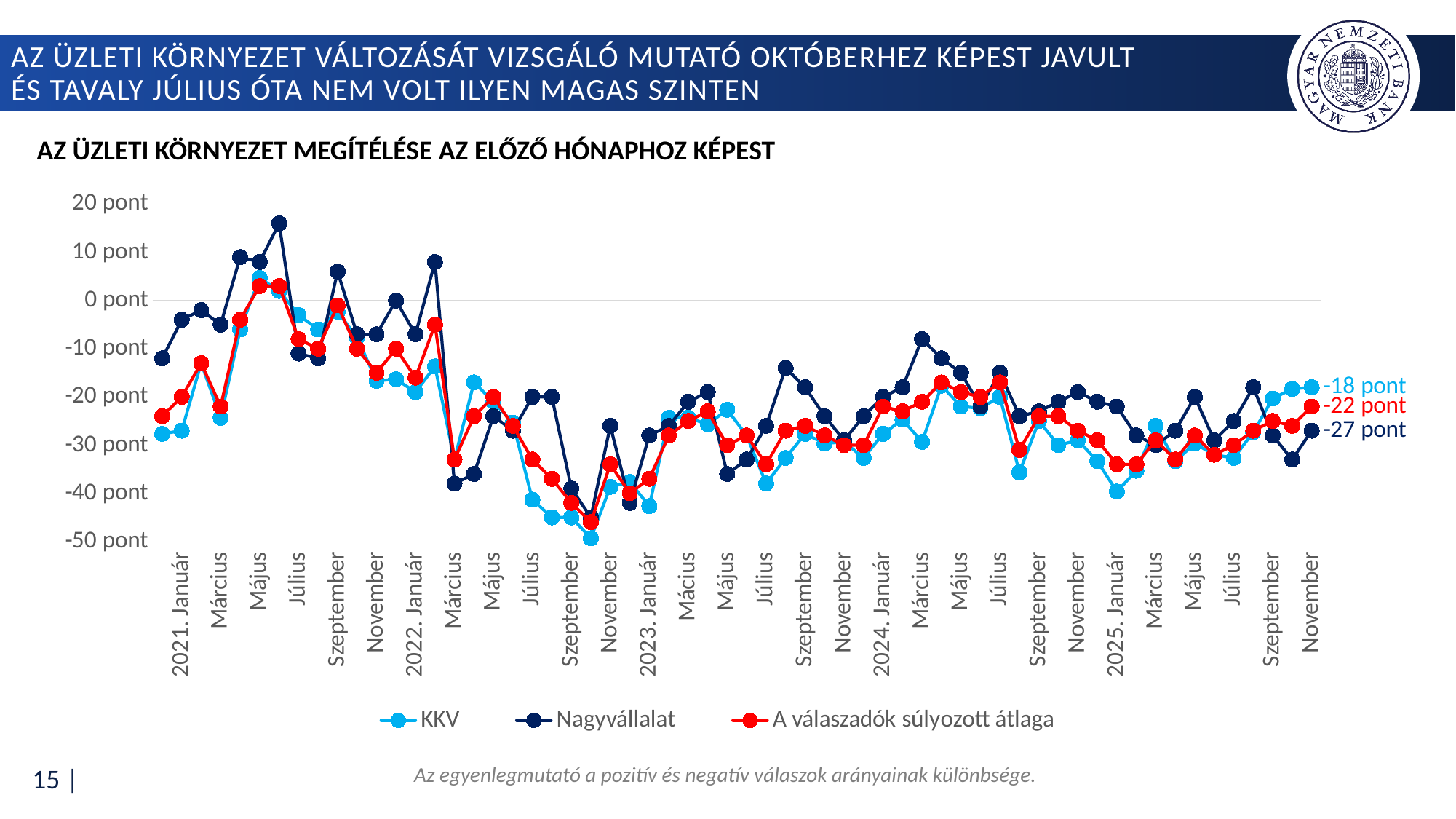
How many series does the legend list? 3 Which series has the highest value at 2025 November? KKV What kind of chart is shown on the slide? line chart What is the value of the Nagyvállalat series at the last point (2025 November)? -27 pont At 2025 November, which is higher: the KKV value or the Nagyvállalat value? KKV What is the value of 'A válaszadók súlyozott átlaga' at the last point (2025 November)? -22 pont What is the value of the KKV series at the last point (2025 November)? -18 pont Is the Nagyvállalat value in 2021 Március greater or less than -10 pont? greater At 2025 November, what is the difference between the KKV value and the Nagyvállalat value? 9 pont Is the KKV value in 2022 Szeptember greater or less than -40 pont? less Which series has the lowest value at 2025 November? Nagyvállalat What is the title of the chart? AZ ÜZLETI KÖRNYEZET MEGÍTÉLÉSE AZ ELŐZŐ HÓNAPHOZ KÉPEST